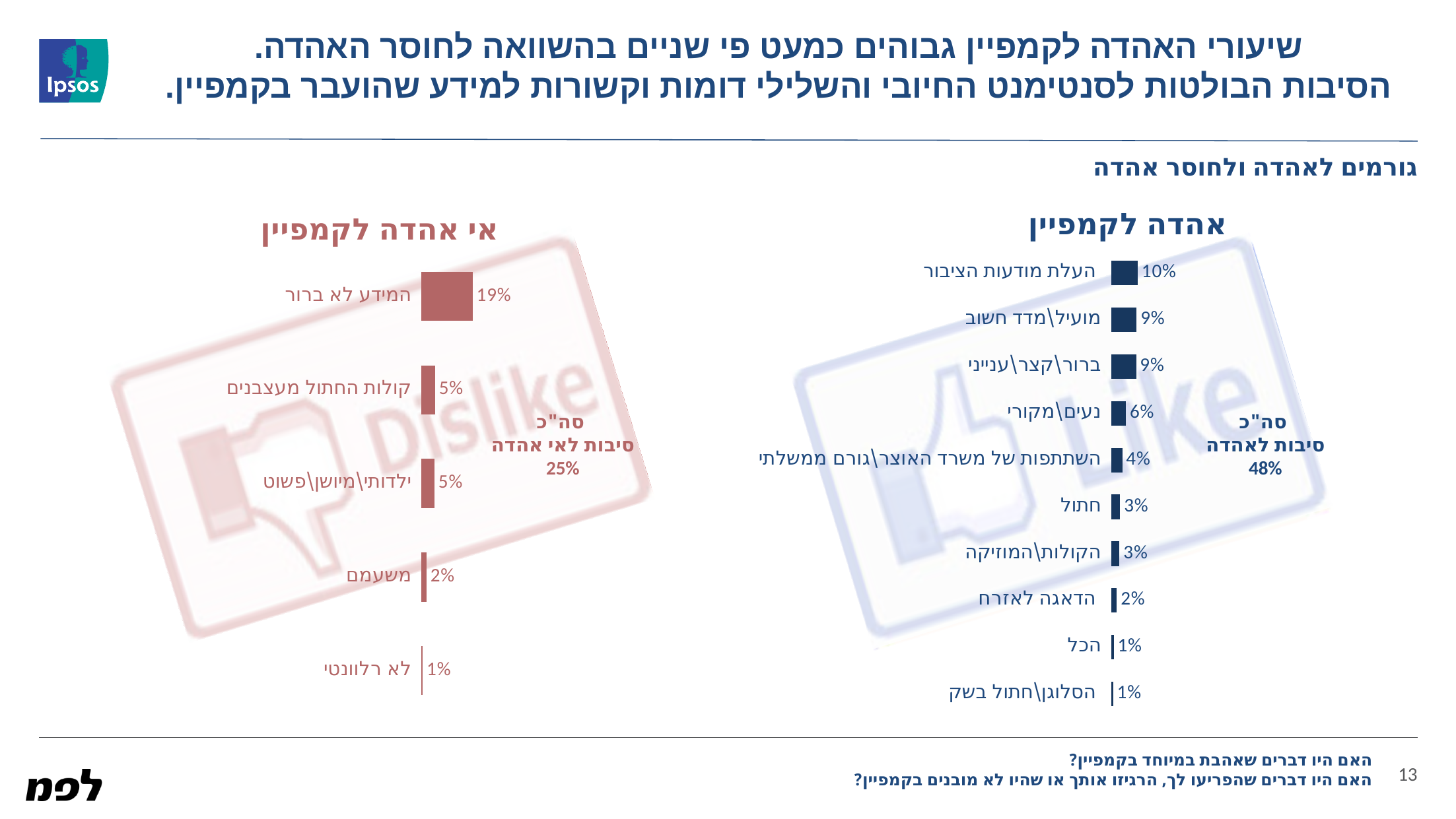
In the 'אהדה לקמפיין' chart, which is larger: 'נעים\מקורי' or 'חתול'? נעים\מקורי In the 'אי אהדה לקמפיין' chart, what is the value for 'המידע לא ברור'? 19% In the 'אי אהדה לקמפיין' chart, which category has the lowest value? לא רלוונטי What total is shown for the 'אהדה לקמפיין' chart (סה"כ סיבות לאהדה)? 48% In the 'אהדה לקמפיין' chart, which category has the highest value? העלת מודעות הציבור What kind of chart is the 'אי אהדה לקמפיין' chart? Bar chart How many categories are shown in the 'אי אהדה לקמפיין' chart? 5 In the 'אי אהדה לקמפיין' chart, what is the difference between 'המידע לא ברור' and 'משעמם'? 17% How many categories are shown in the 'אהדה לקמפיין' chart? 10 What total is shown for the 'אי אהדה לקמפיין' chart (סה"כ סיבות לאי אהדה)? 25% In the 'אהדה לקמפיין' chart, what is the value for 'העלת מודעות הציבור'? 10% In the 'אהדה לקמפיין' chart, what is the value for 'השתתפות של משרד האוצר\גורם ממשלתי'? 4%